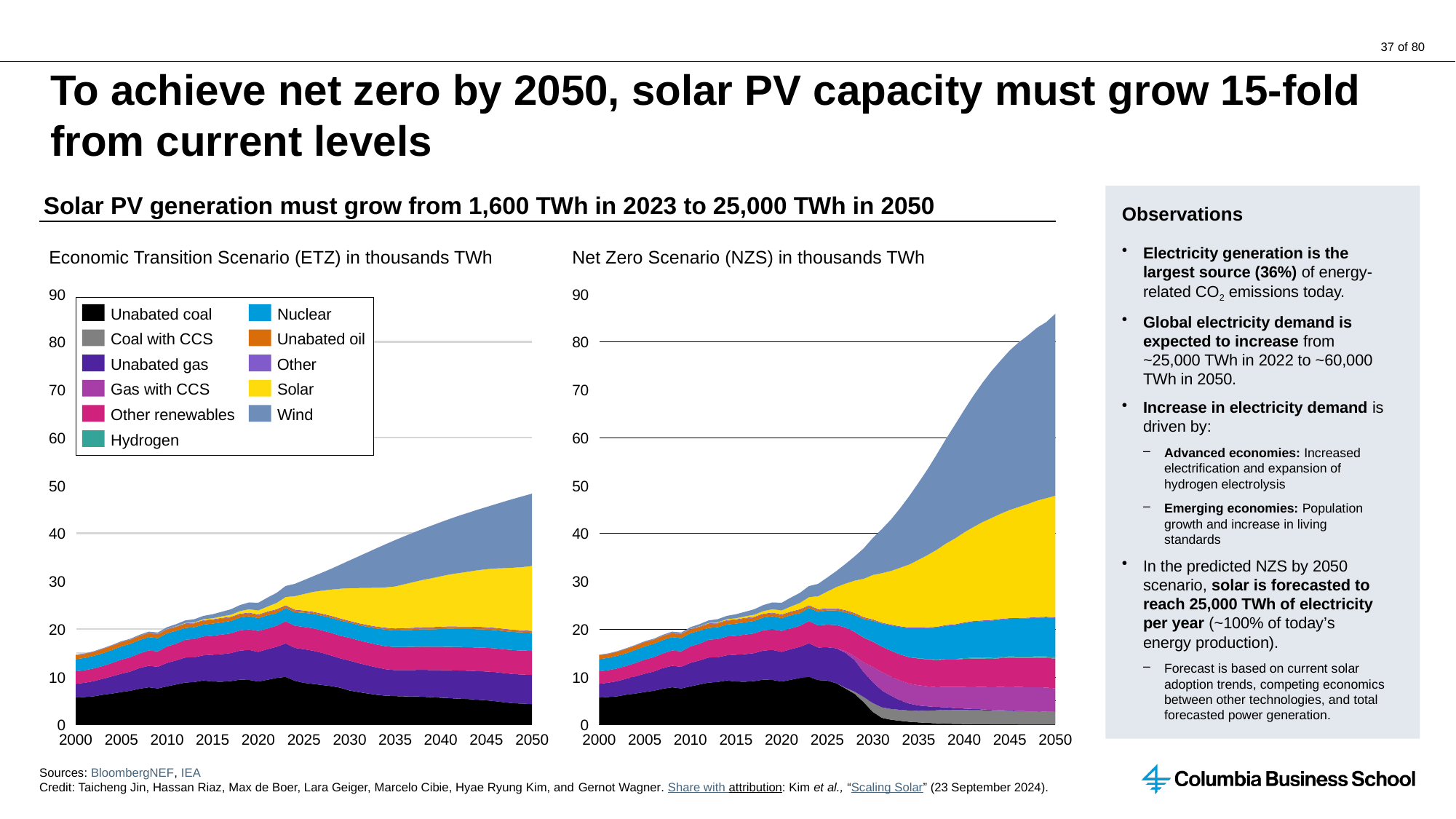
What kind of chart is the Economic Transition Scenario (ETZ) chart? Stacked area chart Which chart shows the higher total generation in 2050, the Economic Transition Scenario (ETZ) or the Net Zero Scenario (NZS)? Net Zero Scenario (NZS) In the Net Zero Scenario (NZS) chart, does the Unabated coal area grow or shrink between 2025 and 2035? Shrink How many series does the legend on the Economic Transition Scenario (ETZ) chart list? 11 In the Net Zero Scenario (NZS) chart, does total generation rise or fall from 2000 to 2050? Rise What is the highest value shown on the y axis of the Net Zero Scenario (NZS) chart? 90 In the Net Zero Scenario (NZS) chart, is the total generation in 2050 greater or less than 80 thousand TWh? greater What is the first year shown on the x axis of the Economic Transition Scenario (ETZ) chart? 2000 What colour represents Solar in the legend of the Economic Transition Scenario (ETZ) chart? Yellow In the Economic Transition Scenario (ETZ) chart, is the total generation in 2050 greater or less than 40 thousand TWh? greater What unit is stated in the title of the Net Zero Scenario (NZS) chart? Thousands TWh In the Net Zero Scenario (NZS) chart, is the total generation in 2000 greater or less than 20 thousand TWh? less